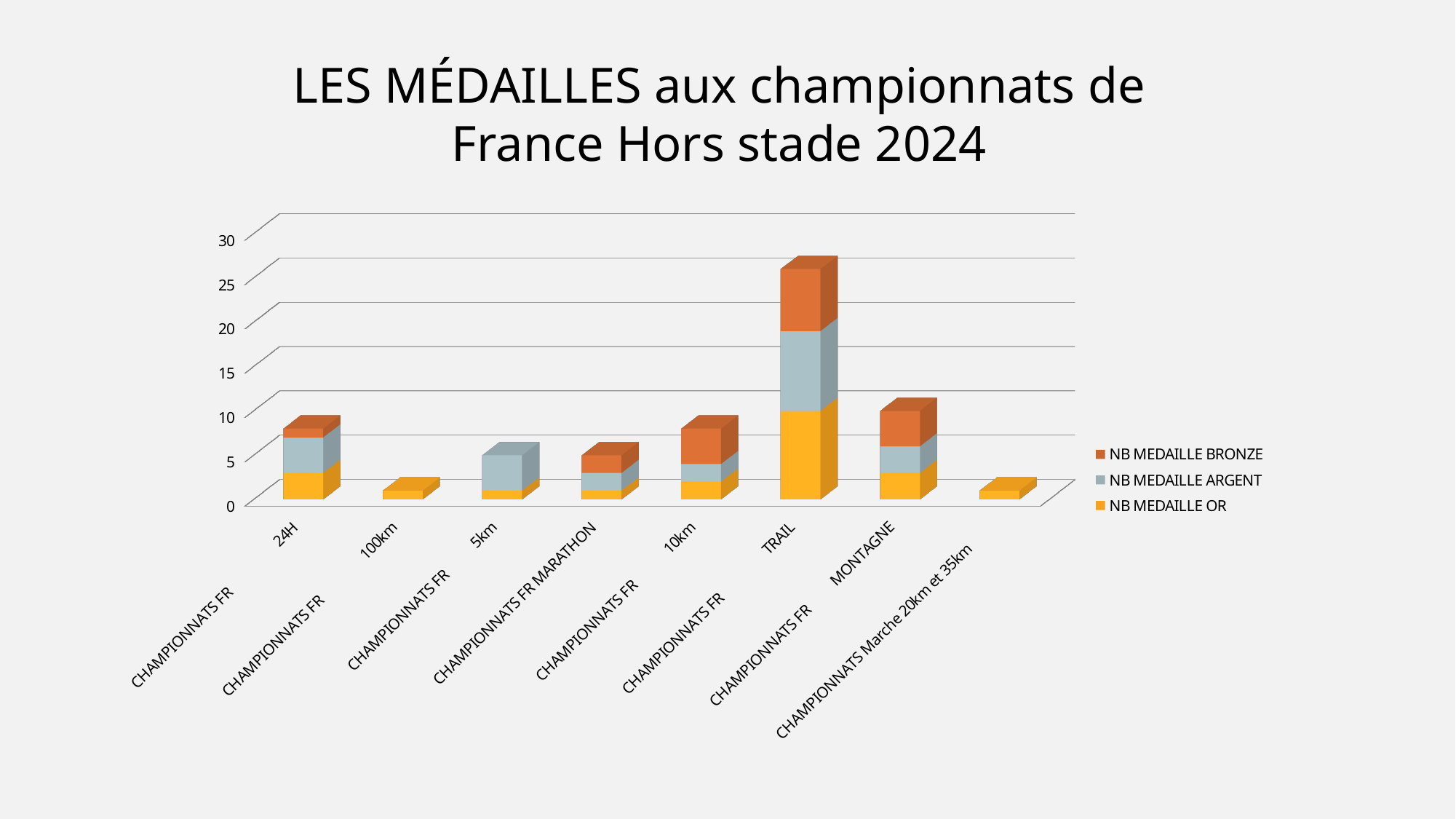
Which has more total medals, CHAMPIONNATS FR 24H or CHAMPIONNATS FR 5km? CHAMPIONNATS FR 24H Which championship has the highest total number of medals? CHAMPIONNATS FR TRAIL Which series is shown in the orange-brown colour at the top of the stacked bars? NB MEDAILLE BRONZE Which has more total medals, CHAMPIONNATS FR TRAIL or CHAMPIONNATS FR MONTAGNE? CHAMPIONNATS FR TRAIL Is the total number of medals for CHAMPIONNATS FR TRAIL greater or less than 20? greater How many championship categories are shown on the x axis? 8 Is the number of gold medals (NB MEDAILLE OR) for CHAMPIONNATS FR TRAIL greater or less than 5? greater What kind of chart is shown on the slide? Stacked bar chart What is the title of the chart? LES MÉDAILLES aux championnats de France Hors stade 2024 Is the total number of medals for CHAMPIONNATS FR 24H greater or less than 10? less How many series does the legend list? 3